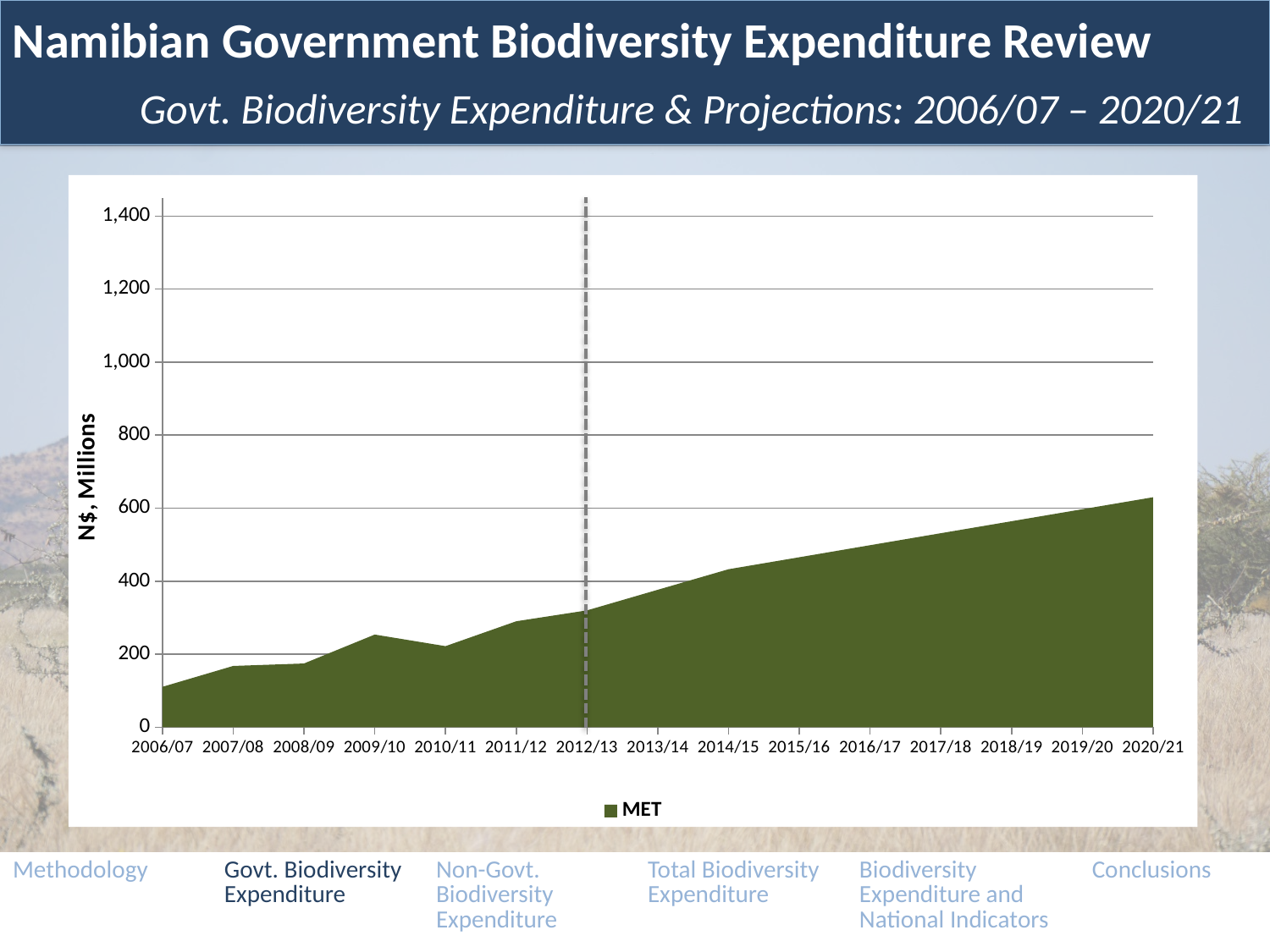
What kind of chart is shown on the slide? area chart Which year has the highest MET expenditure value? 2020/21 Which year has the lowest MET expenditure value? 2006/07 Is the value for 2006/07 greater or less than 200? less Do the MET values generally rise or fall from 2006/07 to 2020/21? rise Is the value for 2020/21 greater or less than 600? greater What is the label on the y axis? N$, Millions How many series does the legend list? 1 Which year has the larger value, 2009/10 or 2010/11? 2009/10 Is the value for 2012/13 greater or less than 400? less How many fiscal years are plotted along the x axis? 15